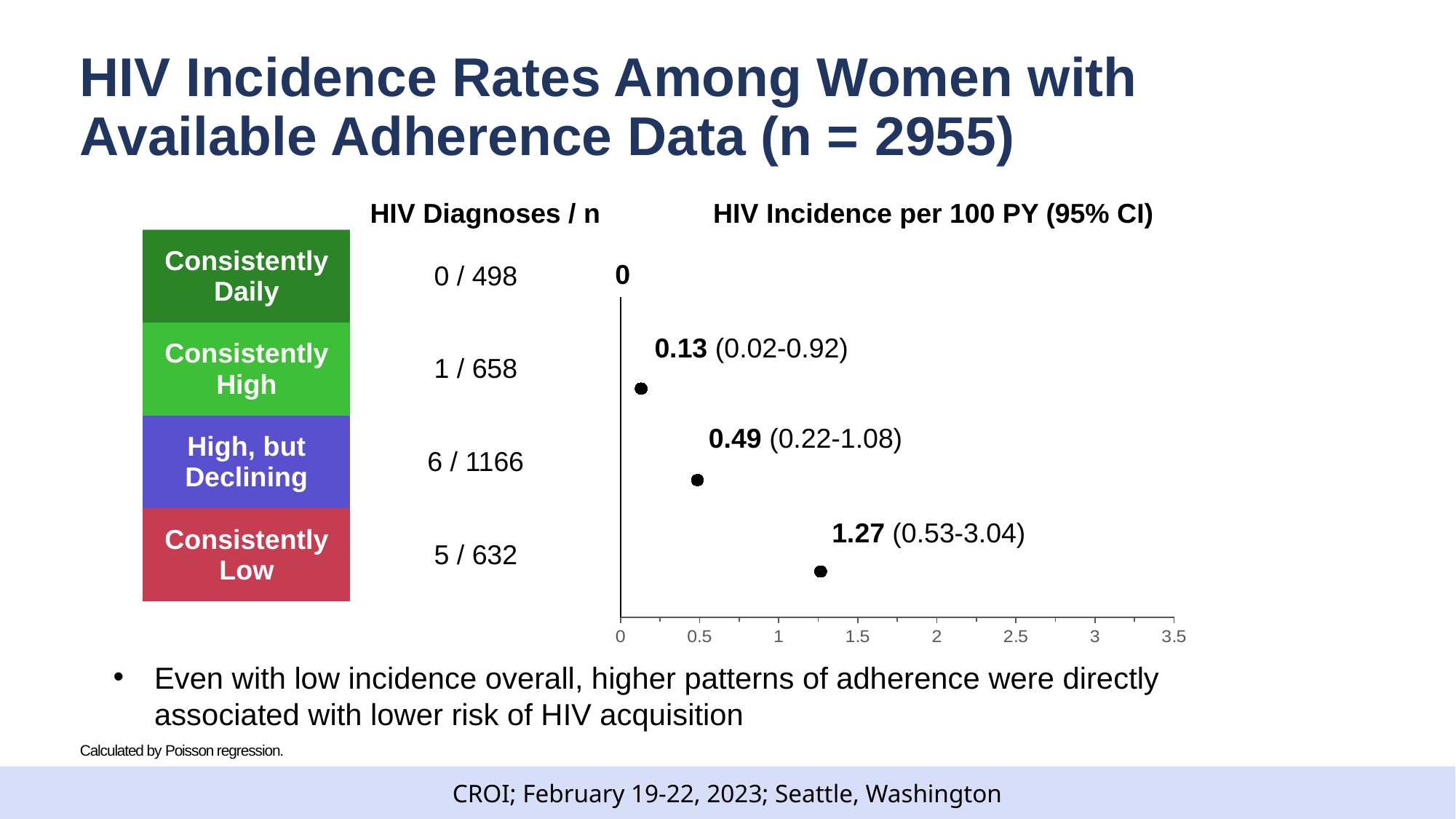
Which adherence group has the lowest HIV incidence per 100 PY? Consistently Daily What is the HIV incidence per 100 PY for the High, but Declining adherence group? 0.49 Which adherence group has the highest HIV incidence per 100 PY? Consistently Low What is the HIV incidence per 100 PY for the Consistently Daily adherence group? 0 How many adherence groups are plotted in the chart? 3 Which group has a higher HIV incidence per 100 PY: Consistently High or High, but Declining? High, but Declining Is the HIV incidence per 100 PY for the Consistently Low group greater or less than 1? greater What is the HIV incidence per 100 PY for the Consistently Low adherence group? 1.27 What is the 95% confidence interval for the HIV incidence in the High, but Declining group? 0.22-1.08 What is the HIV incidence per 100 PY for the Consistently High adherence group? 0.13 What is the difference in HIV incidence per 100 PY between the Consistently Low and High, but Declining groups? 0.78 What is the maximum value shown on the x axis of the chart? 3.5